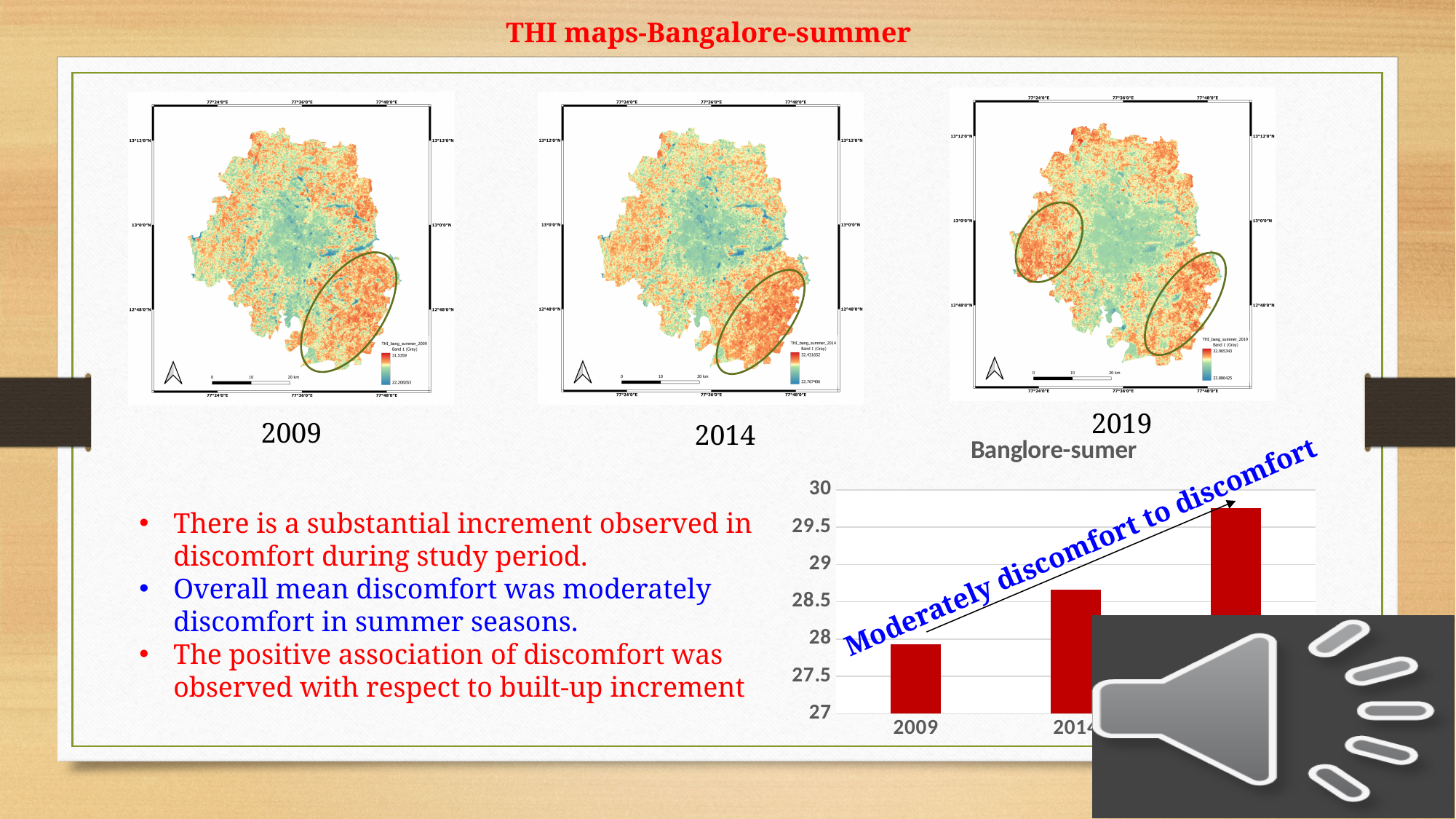
In the 'Banglore-sumer' chart, which bar has the lowest value? 2009 In the 'Banglore-sumer' chart, which is larger, the value for 2009 or the value for 2014? 2014 In the 'Banglore-sumer' chart, do the values rise or fall from left to right along the x axis? rise In the 'Banglore-sumer' chart, what is the highest value shown on the y axis? 30 In the 'Banglore-sumer' chart, is the value of the rightmost bar greater or less than 29.5? greater In the 'Banglore-sumer' chart, is the value for 2009 greater or less than 27.5? greater What is the title of the bar chart on the slide? Banglore-sumer What kind of chart is the 'Banglore-sumer' chart? bar chart In the 'Banglore-sumer' chart, how many bars are plotted? 3 In the 'Banglore-sumer' chart, is the value for 2014 greater or less than 29? less In the 'Banglore-sumer' chart, which bar has the highest value? the rightmost bar